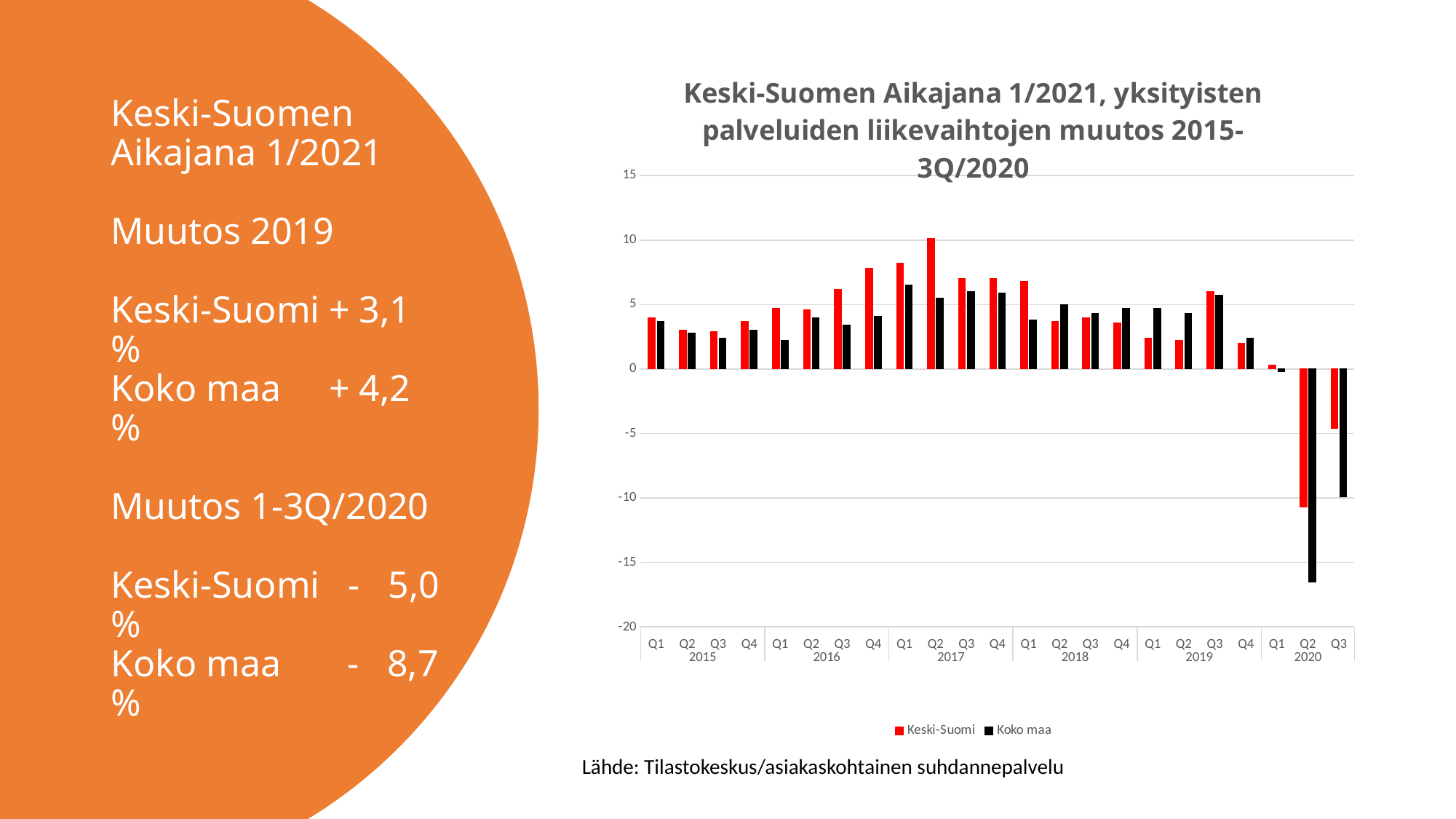
In Q2 2017, which series has the larger value, Keski-Suomi or Koko maa? Keski-Suomi In which quarter does the Koko maa series reach its lowest value? Q2 2020 How many series does the chart legend list? 2 In Q2 2018, which series has the larger value, Keski-Suomi or Koko maa? Koko maa What kind of chart is shown on the slide? Bar chart Is the Keski-Suomi value for Q4 2016 greater or less than 5? greater How many quarters are plotted along the x axis of the chart? 23 Which colour represents the Koko maa series in the chart? Black Does the Koko maa series rise or fall from Q3 2019 to Q2 2020? fall Is the Koko maa value for Q2 2020 greater or less than -15? less In which quarter does the Keski-Suomi series reach its highest value? Q2 2017 Is the Koko maa value for Q1 2016 greater or less than 5? less